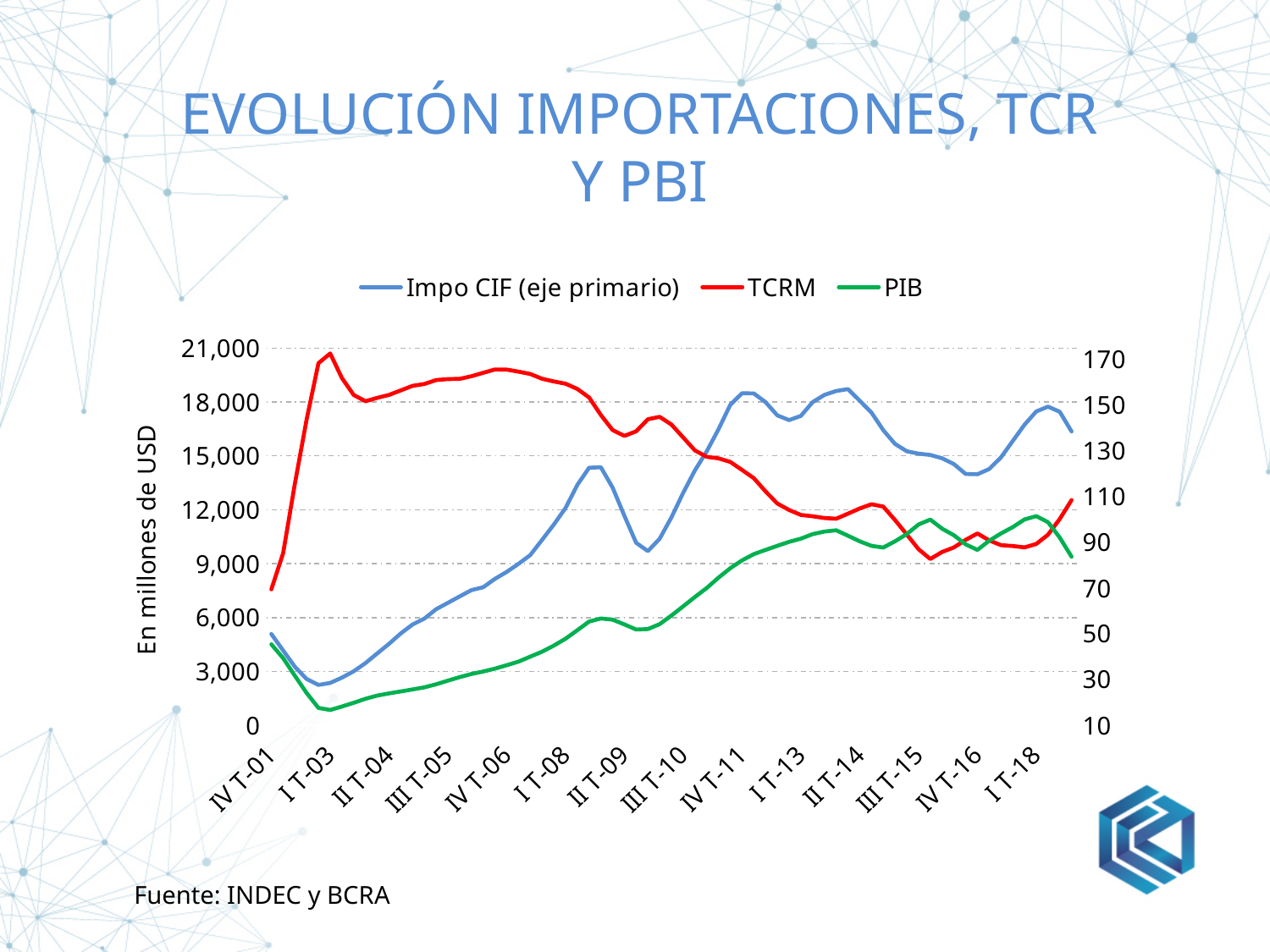
Is the value of PIB at I T-03 greater or less than 30? less Is the value of Impo CIF (eje primario) at I T-03 greater or less than 3,000? less What kind of chart is shown on the slide? Line chart How many series does the legend list? 3 What is the label of the primary (left) vertical axis? En millones de USD What is the title of the chart on the slide? EVOLUCIÓN IMPORTACIONES, TCR Y PBI Is the value of TCRM at I T-03 greater or less than 150? greater At which x-axis label does the TCRM series reach its highest value? I T-03 Which is larger for Impo CIF (eje primario): the value at II T-09 or the value at III T-10? III T-10